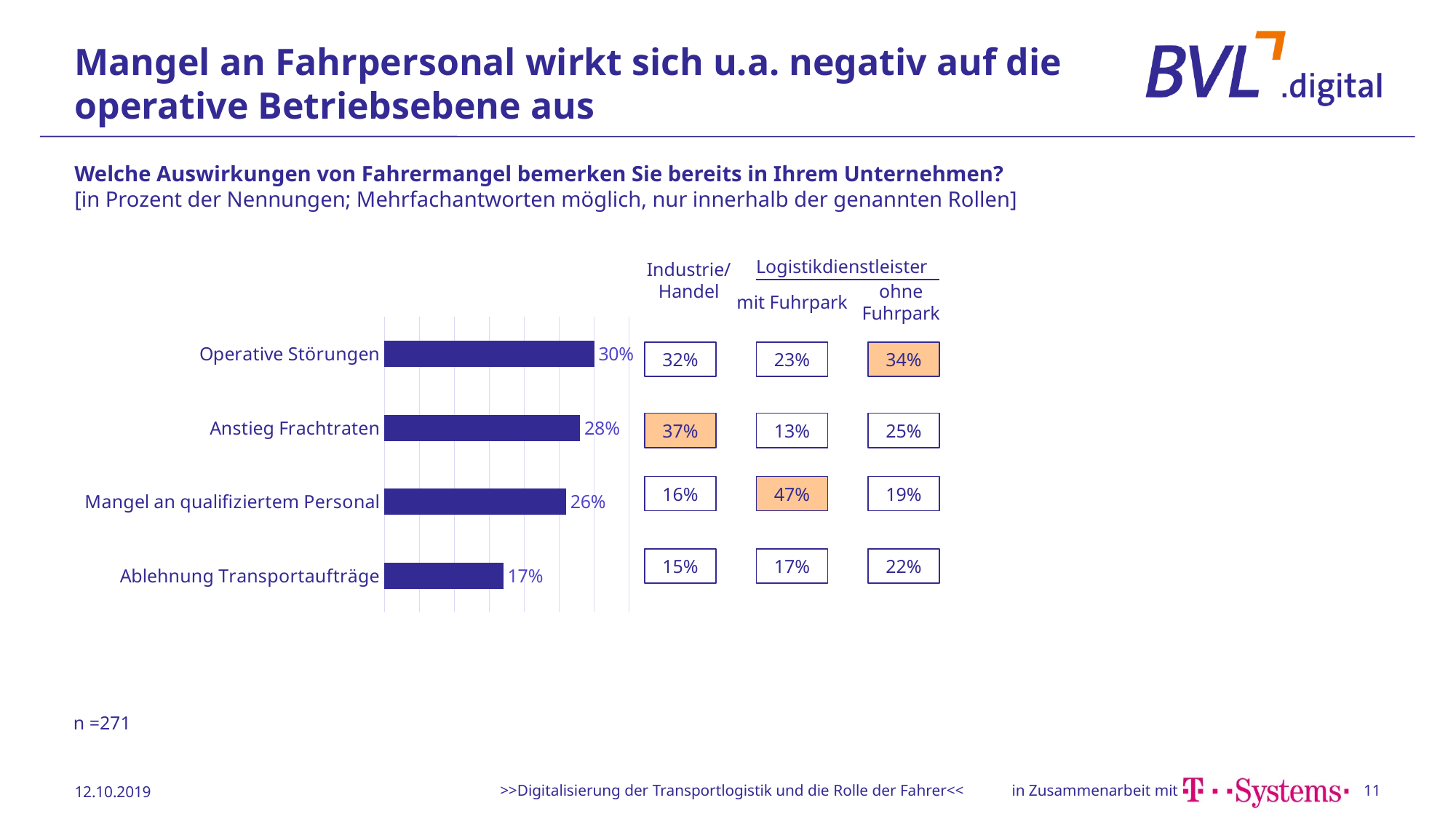
What is the difference between the bar values for Anstieg Frachtraten and Mangel an qualifiziertem Personal? 2% In the table next to the chart, what is the value for Mangel an qualifiziertem Personal in the 'mit Fuhrpark' column? 47% What is the value for Ablehnung Transportaufträge in the bar chart? 17% How many categories are shown in the bar chart? 4 In the table next to the chart, what is the value for Anstieg Frachtraten in the Industrie/Handel column? 37% In the table next to the chart, what is the difference between the 'ohne Fuhrpark' and 'mit Fuhrpark' values for Operative Störungen? 11% What kind of chart is shown on the slide? bar chart Which category has the lowest value in the bar chart? Ablehnung Transportaufträge What is the sample size (n) stated on the slide? n =271 Which is larger in the bar chart: Anstieg Frachtraten or Ablehnung Transportaufträge? Anstieg Frachtraten What is the value for Operative Störungen in the bar chart? 30% Which category has the highest value in the bar chart? Operative Störungen